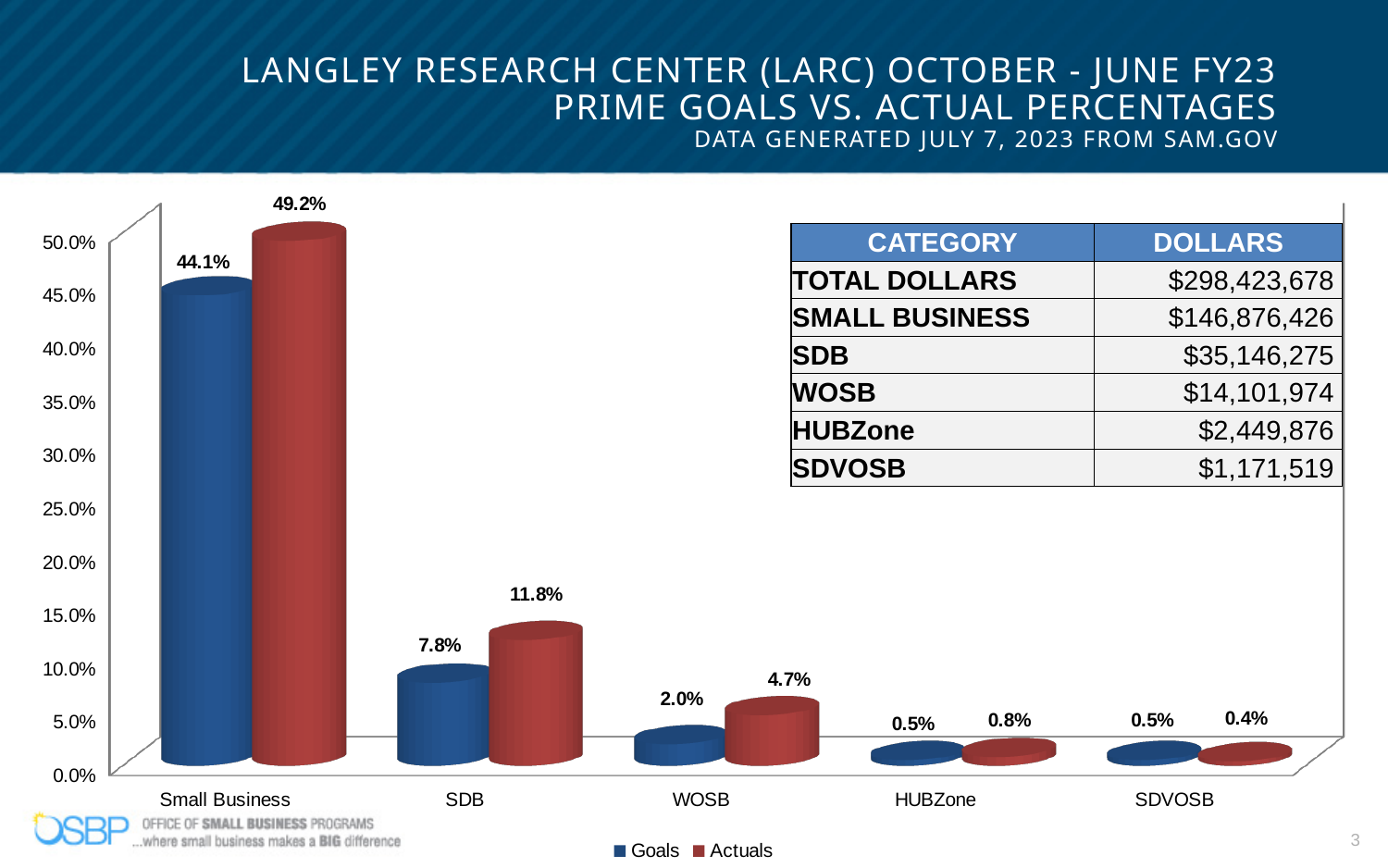
What is the Actuals value for Small Business? 49.2% What is the Goals value for HUBZone? 0.5% What are the two series named in the chart legend? Goals and Actuals Which category has the lowest Actuals value? SDVOSB What is the difference between the Actuals and Goals values for Small Business? 5.1% What is the Goals value for SDB? 7.8% How many series does the chart legend list? 2 For SDVOSB, which is larger, the Goals value or the Actuals value? Goals How many categories are shown on the x axis of the chart? 5 What is the Actuals value for WOSB? 4.7% What kind of chart is shown on the slide? Bar chart Which category has the highest Actuals value? Small Business